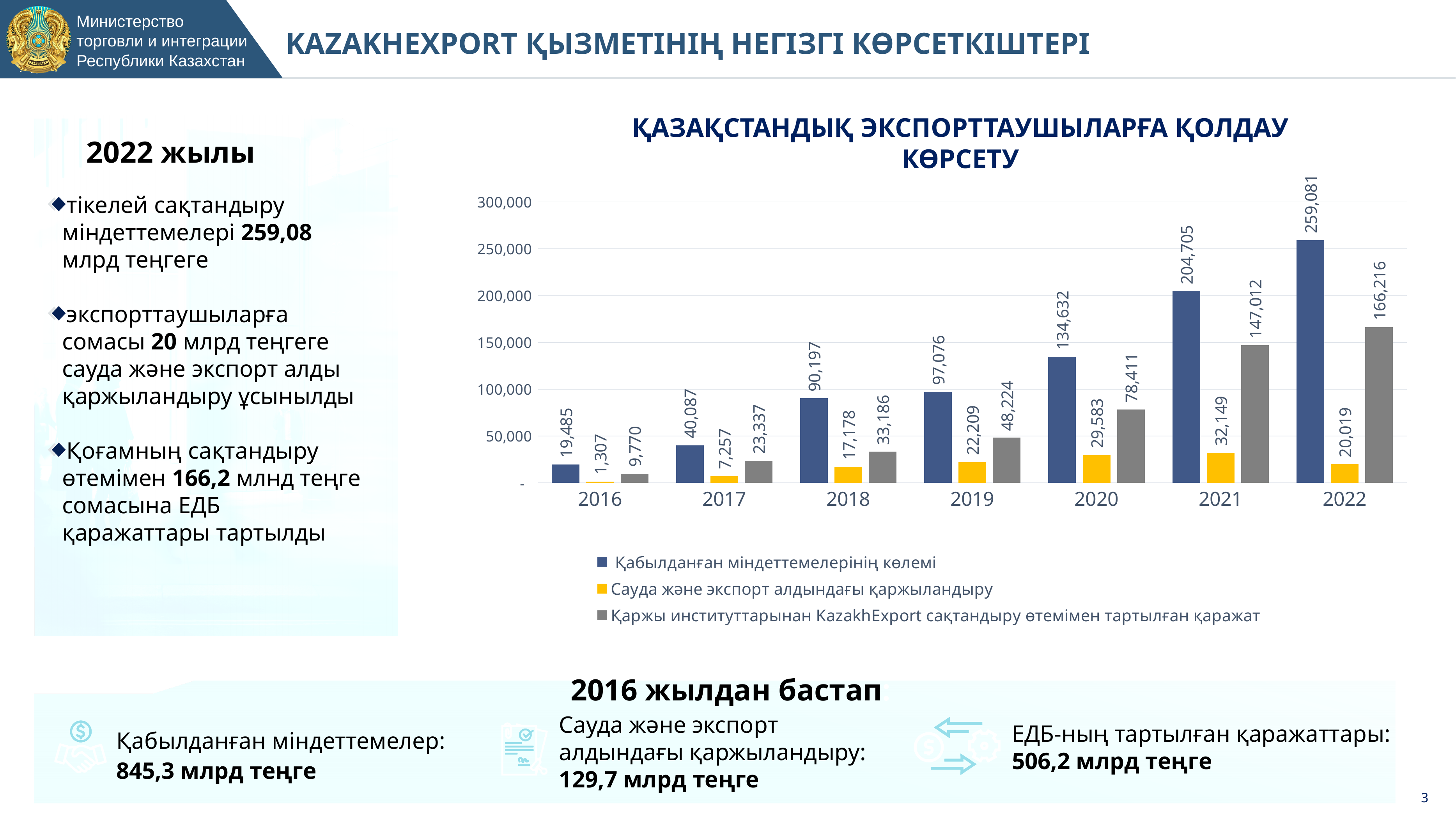
How many years are shown on the x axis of the chart? 7 What type of chart is shown on the slide? bar chart Which is larger in 2020: 'Сауда және экспорт алдындағы қаржыландыру' or 'Қаржы институттарынан KazakhExport сақтандыру өтемімен тартылған қаражат'? Қаржы институттарынан KazakhExport сақтандыру өтемімен тартылған қаражат What is the value of 'Қабылданған міндеттемелерінің көлемі' for 2022? 259,081 In which year is 'Сауда және экспорт алдындағы қаржыландыру' highest? 2021 In which year is 'Қабылданған міндеттемелерінің көлемі' lowest? 2016 What is the value of 'Қаржы институттарынан KazakhExport сақтандыру өтемімен тартылған қаражат' for 2021? 147,012 Does 'Қабылданған міндеттемелерінің көлемі' generally rise or fall from 2016 to 2022? rise What is the difference between 'Қабылданған міндеттемелерінің көлемі' in 2022 and in 2021? 54,376 What is the title of the chart? ҚАЗАҚСТАНДЫҚ ЭКСПОРТТАУШЫЛАРҒА ҚОЛДАУ КӨРСЕТУ What is the value of 'Сауда және экспорт алдындағы қаржыландыру' for 2019? 22,209 How many series does the chart legend list? 3